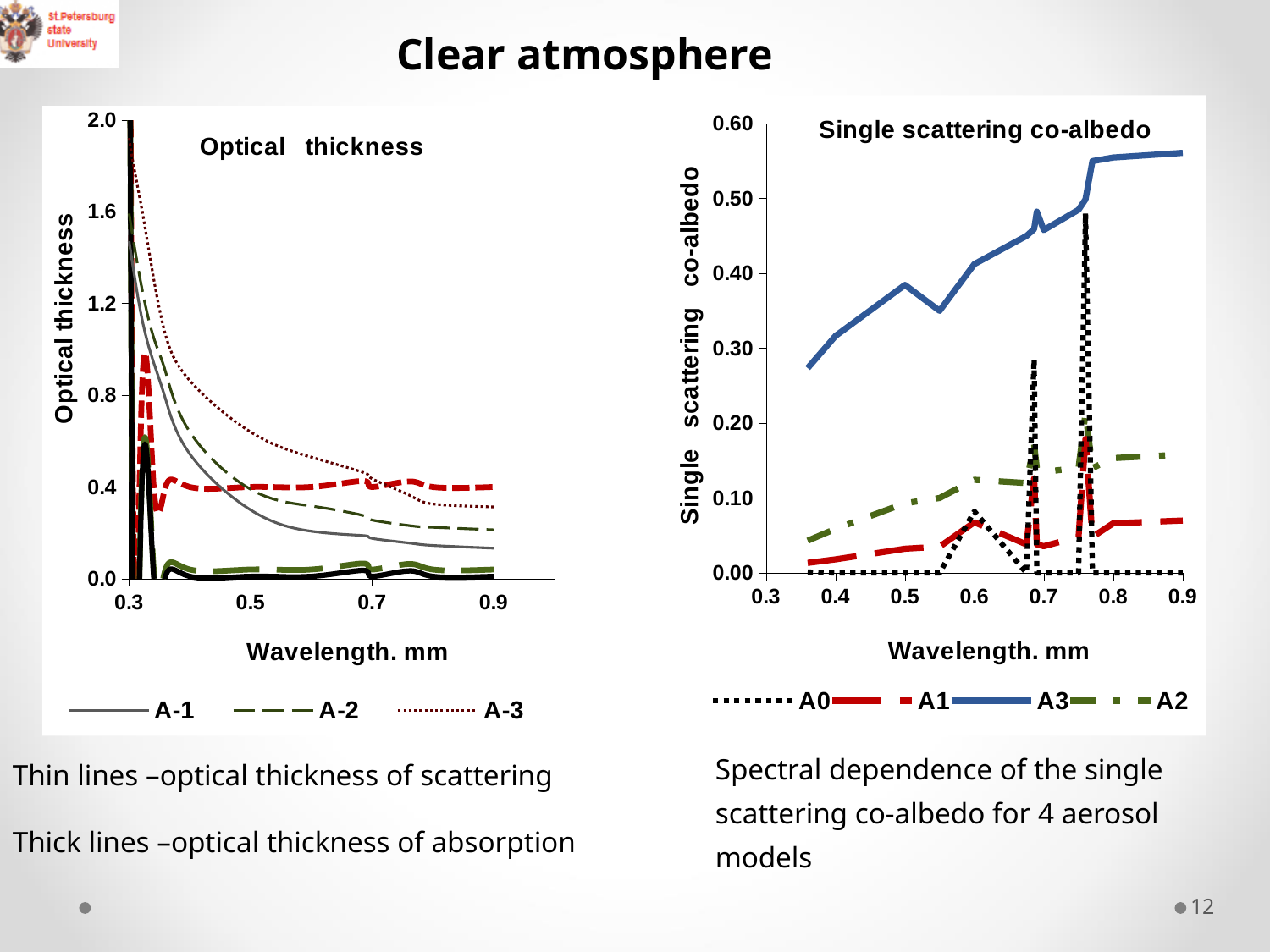
What kind of chart is the 'Optical thickness' chart on the left? line chart What kind of chart is the 'Single scattering co-albedo' chart on the right? line chart What is the x-axis label of the 'Single scattering co-albedo' chart? Wavelength. mm In the 'Single scattering co-albedo' chart, which series has the highest values across the wavelength range? A3 In the 'Single scattering co-albedo' chart, which is larger at wavelength 0.9: A3 or A2? A3 In the 'Single scattering co-albedo' chart, does the A3 series rise or fall as wavelength increases from 0.4 to 0.9? rise In the 'Single scattering co-albedo' chart, is the value of A1 at wavelength 0.9 greater or less than 0.10? less In the 'Single scattering co-albedo' chart, is the value of A3 at wavelength 0.9 greater or less than 0.50? greater How many series does the legend of the 'Single scattering co-albedo' chart list? 4 In the 'Single scattering co-albedo' chart, is the value of A2 at wavelength 0.9 greater or less than 0.10? greater In the 'Optical thickness' chart, does the thin A-3 line rise or fall as wavelength increases from 0.3 to 0.9? fall How many series does the legend of the 'Optical thickness' chart list? 3